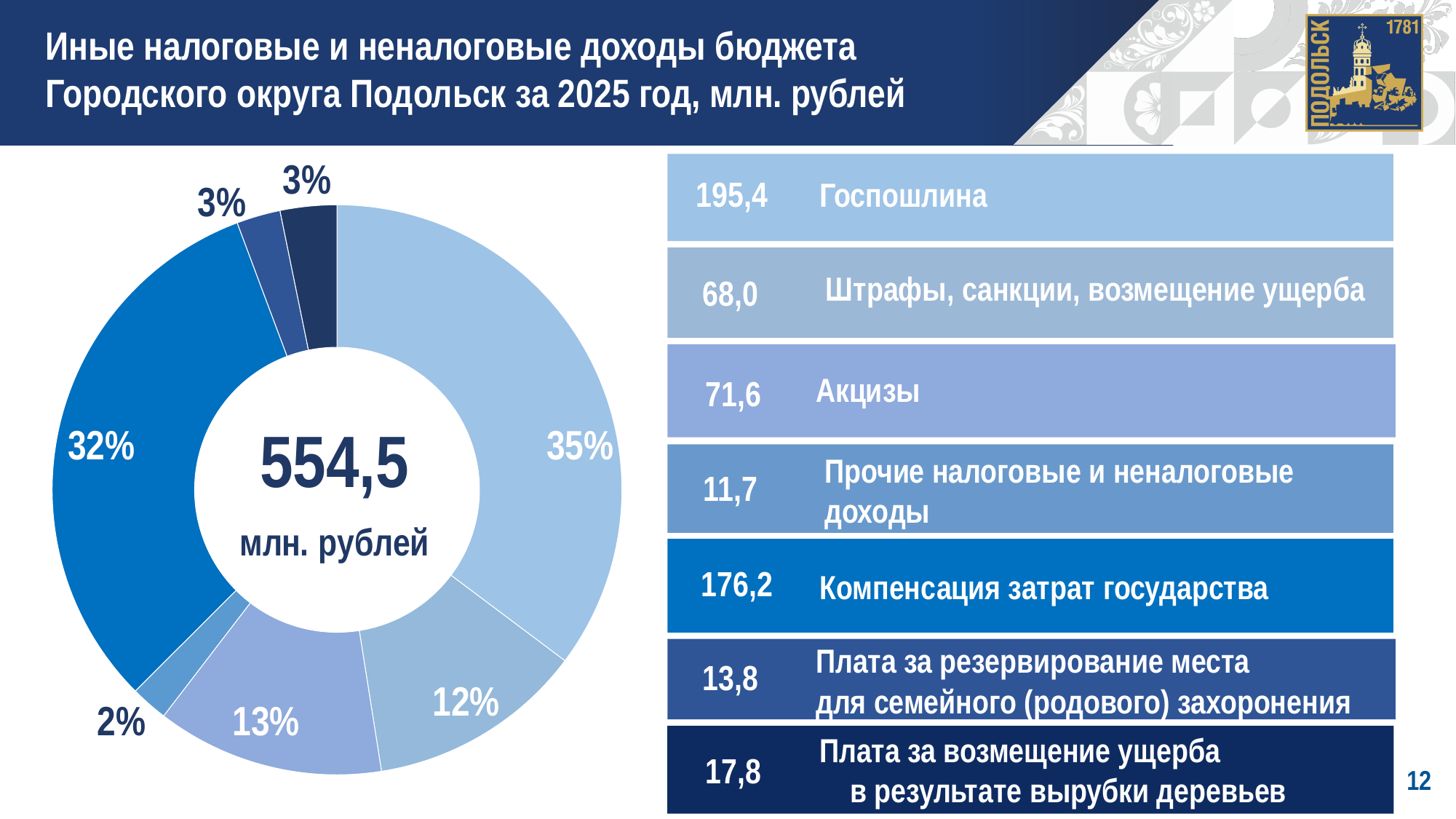
What is the value for Компенсация затрат государства? 176,2 What is the difference between the values for Госпошлина and Компенсация затрат государства? 19,2 What total value is shown in the centre of the donut chart? 554,5 млн. рублей Which category has the highest value? Госпошлина What kind of chart is shown on the slide? pie chart (donut) How many categories does the legend list? 7 What is the value for Госпошлина? 195,4 What share of the donut chart does the largest slice (Госпошлина) take? 35% Which is larger: Штрафы, санкции, возмещение ущерба or Акцизы? Акцизы What is the value for Плата за возмещение ущерба в результате вырубки деревьев? 17,8 What is the value for Акцизы? 71,6 Which category has the lowest value? Прочие налоговые и неналоговые доходы